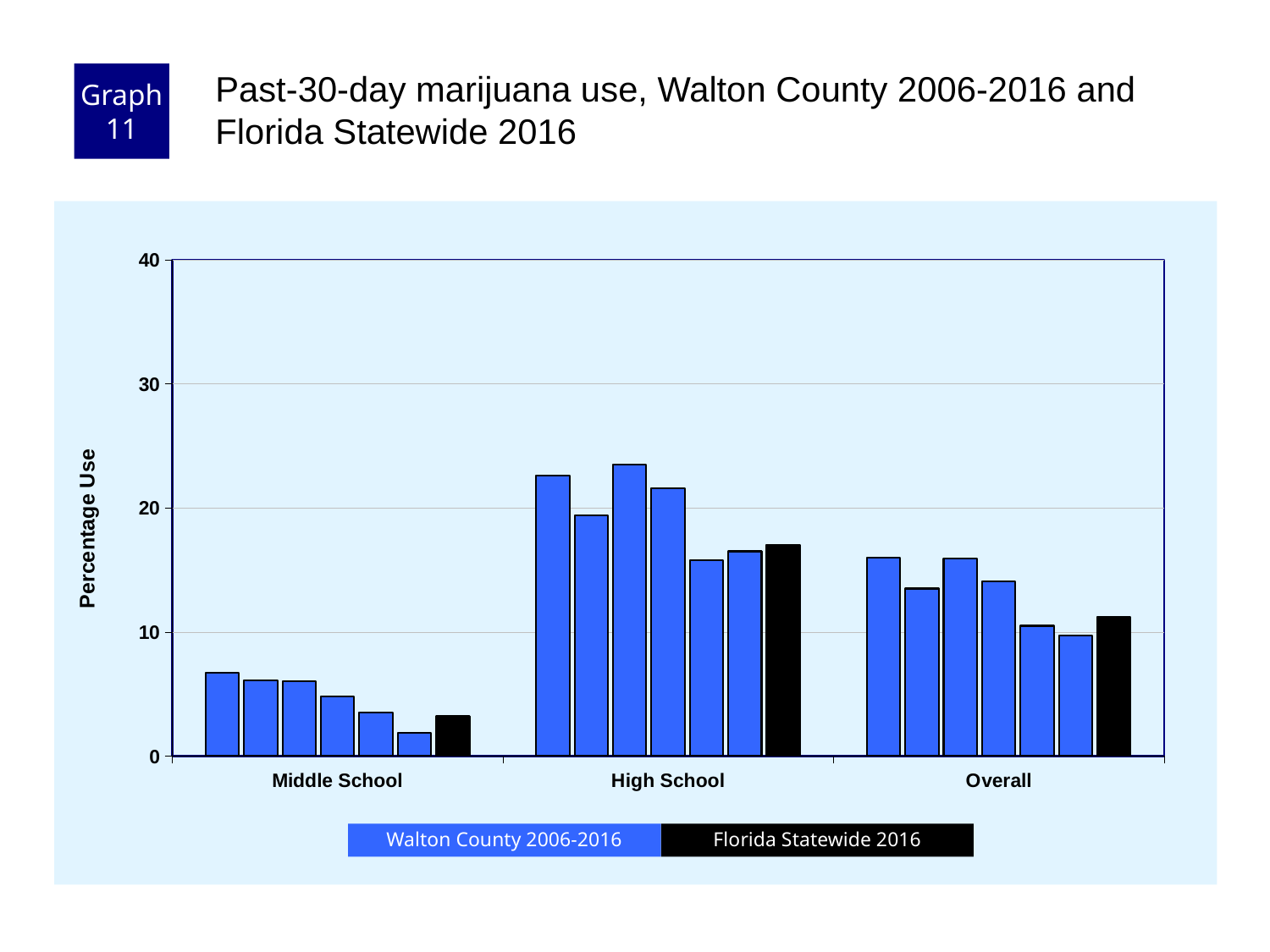
Is the Florida Statewide 2016 value for High School greater or less than 10? greater How many series does the legend list? 2 What is the label on the y axis? Percentage Use What colour represents Florida Statewide 2016 in the legend? black Is the Florida Statewide 2016 value for Overall greater or less than 20? less Which is larger: the Florida Statewide 2016 value for High School or for Middle School? High School Which category has the lowest bars overall? Middle School Which category has the highest bars overall? High School How many categories are shown on the x axis? 3 Is the Florida Statewide 2016 value for High School greater or less than 20? less What kind of chart is shown on the slide? bar chart